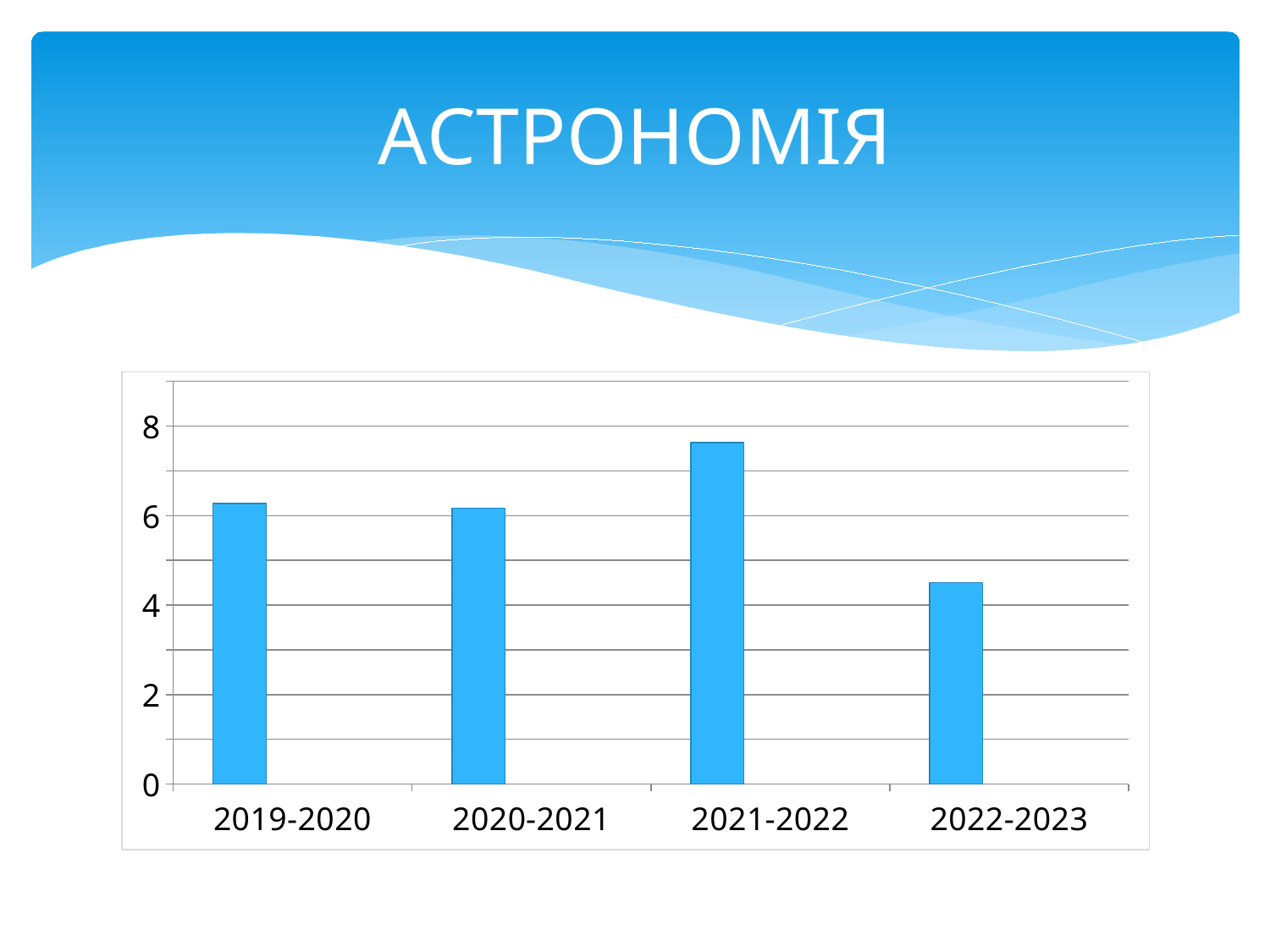
Is the value for 2022-2023 greater or less than 6? less Is the value for 2021-2022 greater or less than 6? greater Is the value for 2022-2023 greater or less than 4? greater What is the title of the slide containing the chart? АСТРОНОМІЯ Which is larger, the value for 2019-2020 or the value for 2022-2023? 2019-2020 What kind of chart is shown on the slide? bar chart Which school year has the lowest bar in the chart? 2022-2023 Which school year has the highest bar in the chart? 2021-2022 Which is larger, the value for 2021-2022 or the value for 2022-2023? 2021-2022 How many categories (school years) are shown on the x axis of the chart? 4